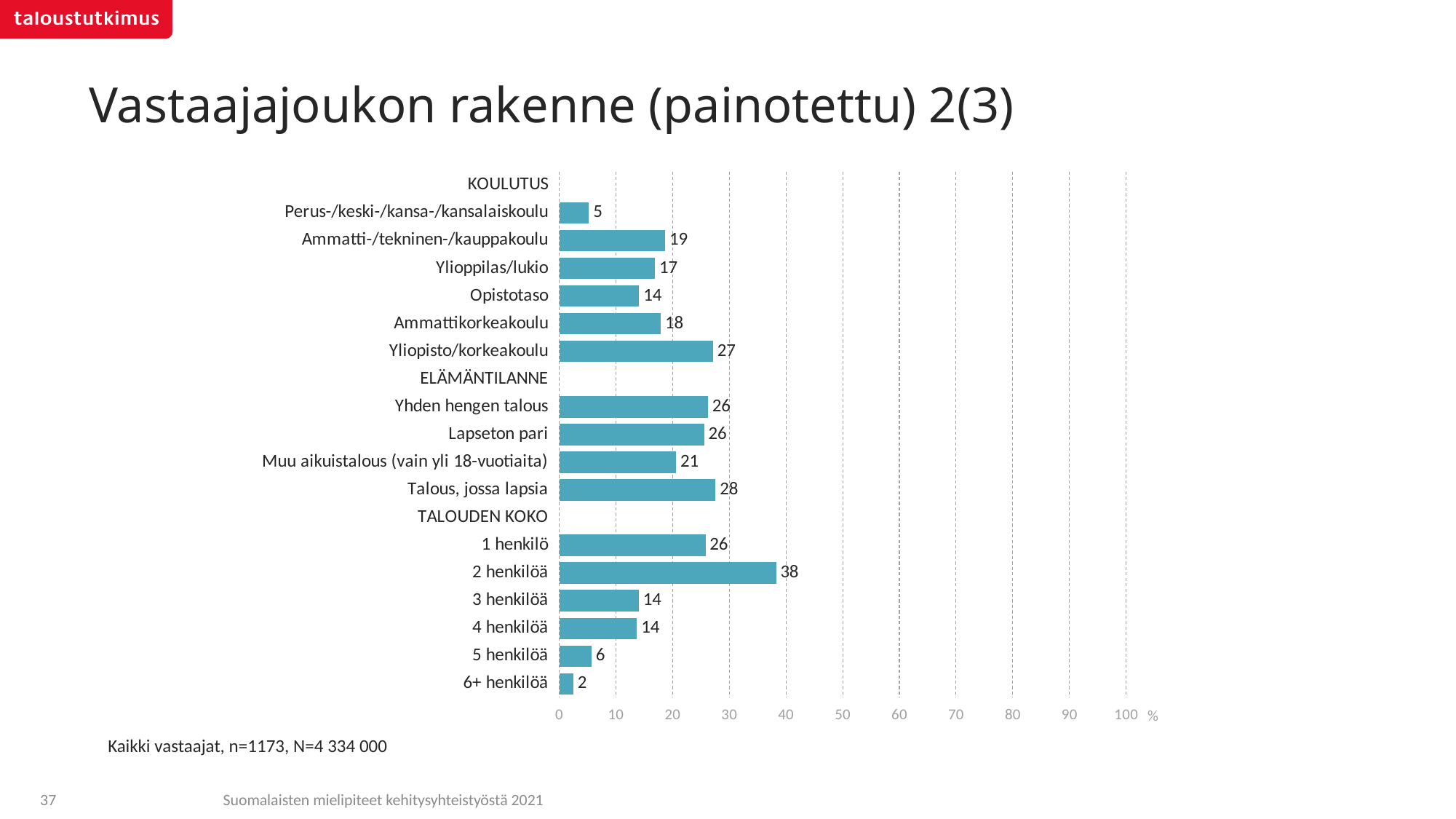
Is the value for Talous, jossa lapsia greater or less than 20? greater What is the difference between the values for 2 henkilöä and 1 henkilö? 12 What unit is shown at the end of the x axis? % What is the value for 2 henkilöä? 38 Which is larger, the value for Ammatti-/tekninen-/kauppakoulu or the value for Ylioppilas/lukio? Ammatti-/tekninen-/kauppakoulu How many bars are plotted in the chart? 17 What is the value for Yliopisto/korkeakoulu? 27 Which category has the highest value in the chart? 2 henkilöä Which category has the lowest value in the chart? 6+ henkilöä What kind of chart is shown on the slide? bar chart What is the difference between the values for Yliopisto/korkeakoulu and Perus-/keski-/kansa-/kansalaiskoulu? 22 What is the value for Muu aikuistalous (vain yli 18-vuotiaita)? 21